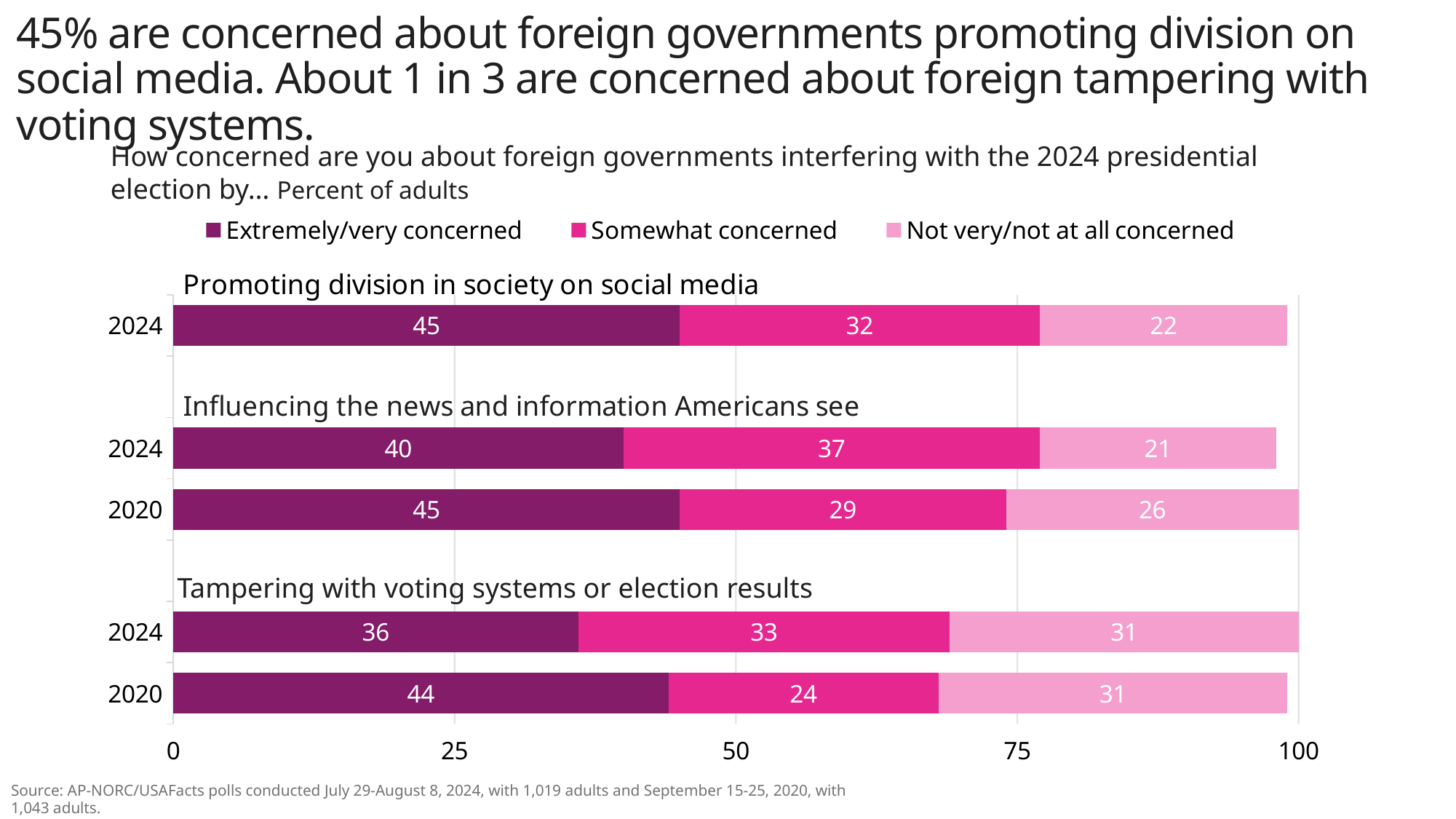
What is the total of the three segments in the 2024 bar for tampering with voting systems or election results? 100 Which bar has the highest not very/not at all concerned value? Tampering with voting systems or election results (2024 and 2020, both 31) What kind of chart is shown on the slide? Stacked bar chart What percentage of adults were not very/not at all concerned about tampering with voting systems or election results in 2020? 31 What percentage of adults were somewhat concerned about foreign governments influencing the news and information Americans see in 2024? 37 How many bars are plotted in the chart? 5 By how many percentage points did the share extremely/very concerned about tampering with voting systems or election results change from 2020 to 2024? 8 What percentage of adults were extremely/very concerned about foreign governments promoting division in society on social media in 2024? 45 Which is larger: the somewhat concerned share for influencing the news in 2024 or for influencing the news in 2020? 2024 What is the first legend entry in the chart? Extremely/very concerned How many series does the legend list? 3 Which bar has the lowest extremely/very concerned value? Tampering with voting systems or election results, 2024